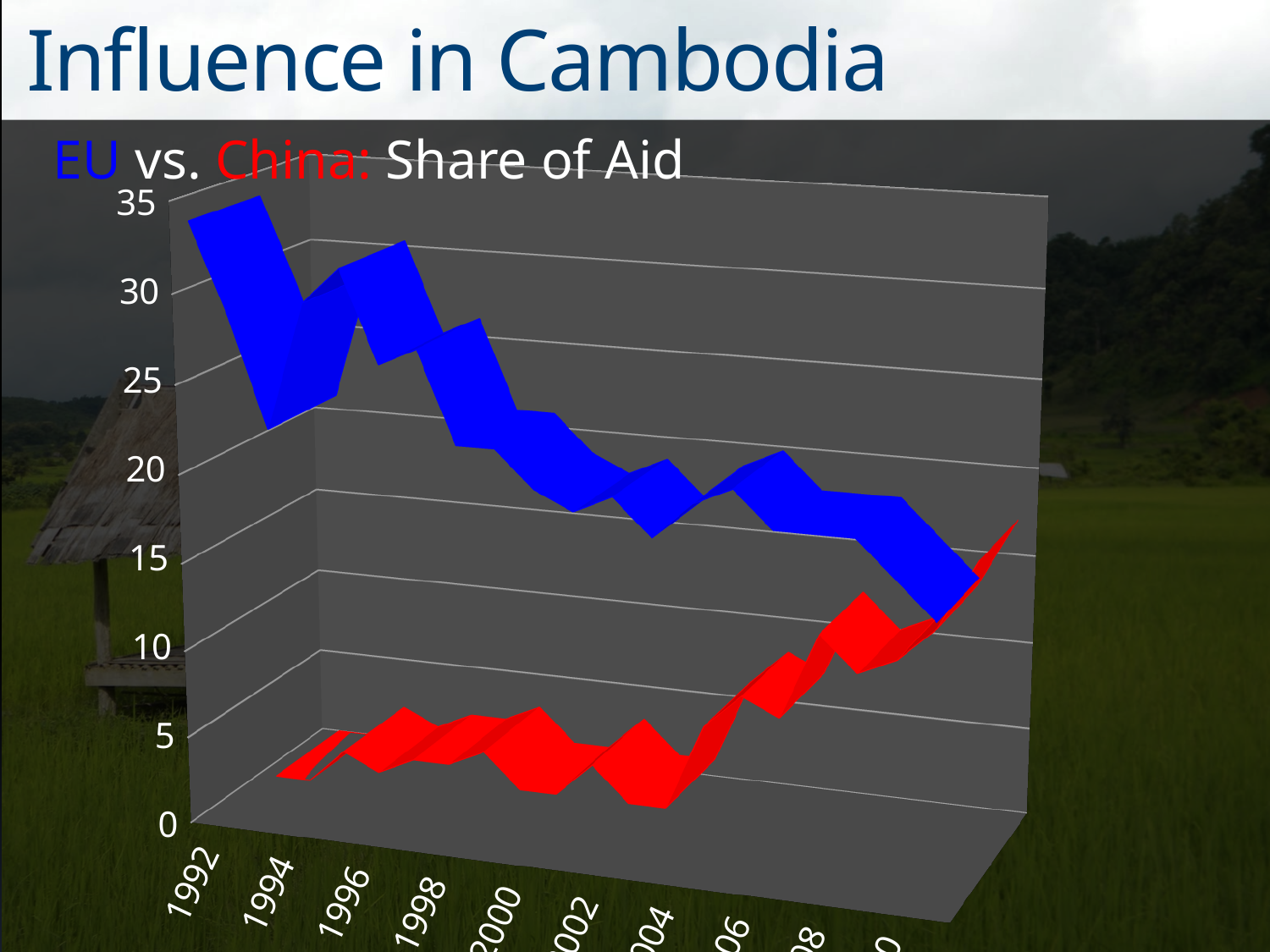
Is China's share of aid in 2010 greater or less than 10? greater How many series does the chart show? 2 Which colour represents China in the chart? red In 1996, which has the larger share of aid, the EU or China? EU Is the EU's share of aid in 2010 greater or less than 20? less In which year is the EU's share of aid highest? 1992 Is the EU's share of aid in 1992 greater or less than 30? greater What kind of chart is shown on the slide? line chart Does China's share of aid rise or fall from 2004 to 2010? rise Does the EU's share of aid rise or fall from 1992 to 2010? fall What is the title of the chart? EU vs. China: Share of Aid